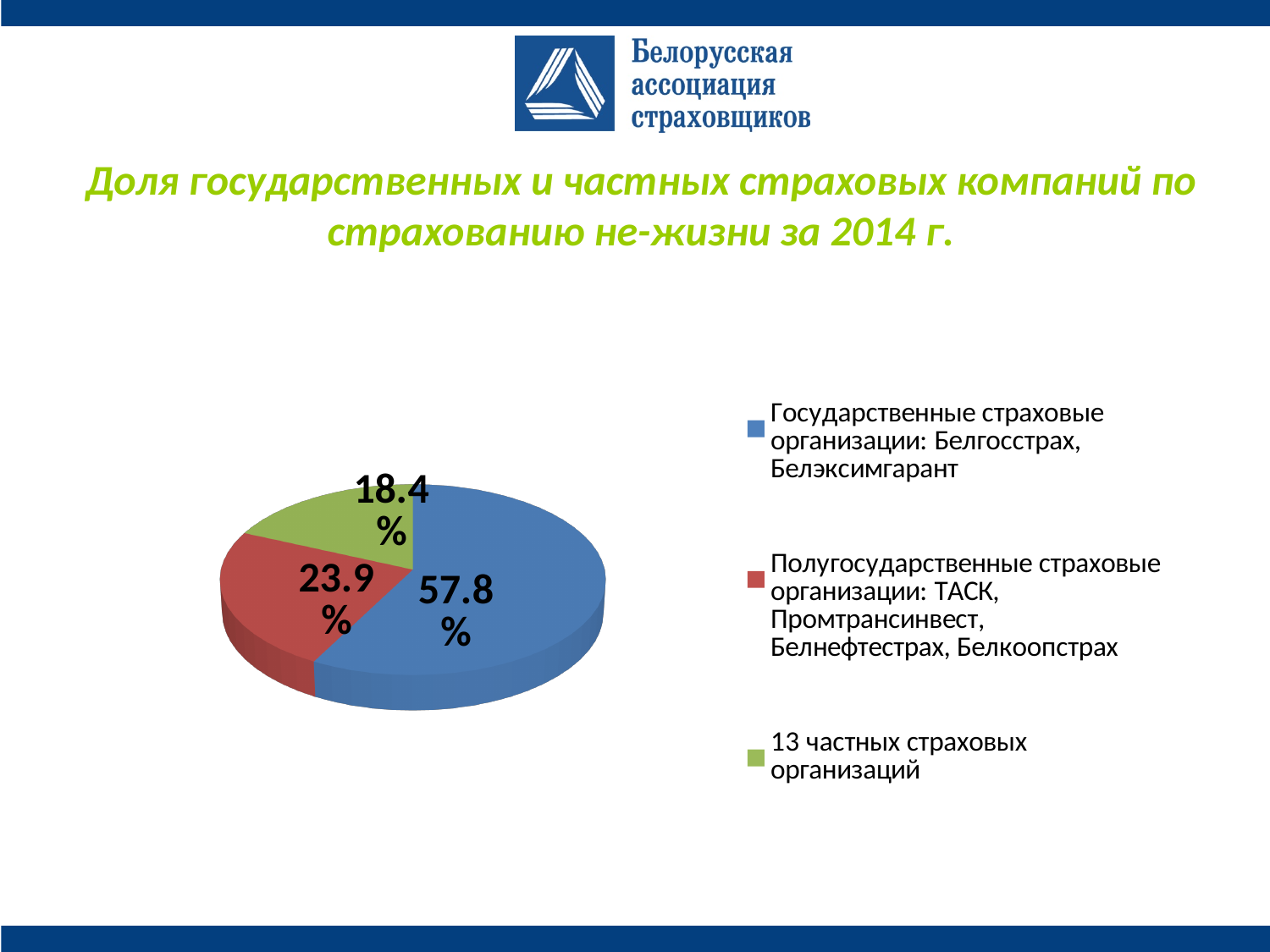
What type of chart is shown on the slide? Pie chart What share of the pie do the state insurance organizations (Белгосстрах, Белэксимгарант) hold? 57.8% Which is larger: the share of semi-state insurance organizations or the share of private insurance organizations? Полугосударственные страховые организации Which category has the smallest slice of the pie? 13 частных страховых организаций What share of the pie do the 13 private insurance organizations hold? 18.4% How many slices does the pie chart have? 3 What colour is the slice for the 13 private insurance organizations? Green Which category has the largest slice of the pie? Государственные страховые организации: Белгосстрах, Белэксимгарант What share of the pie do the semi-state insurance organizations (ТАСК, Промтрансинвест, Белнефтестрах, Белкоопстрах) hold? 23.9% How many entries does the legend list? 3 What is the difference in percentage points between the state insurance organizations' share and the private insurance organizations' share? 39.4 What is the difference in percentage points between the semi-state and the private insurance organizations' shares? 5.5